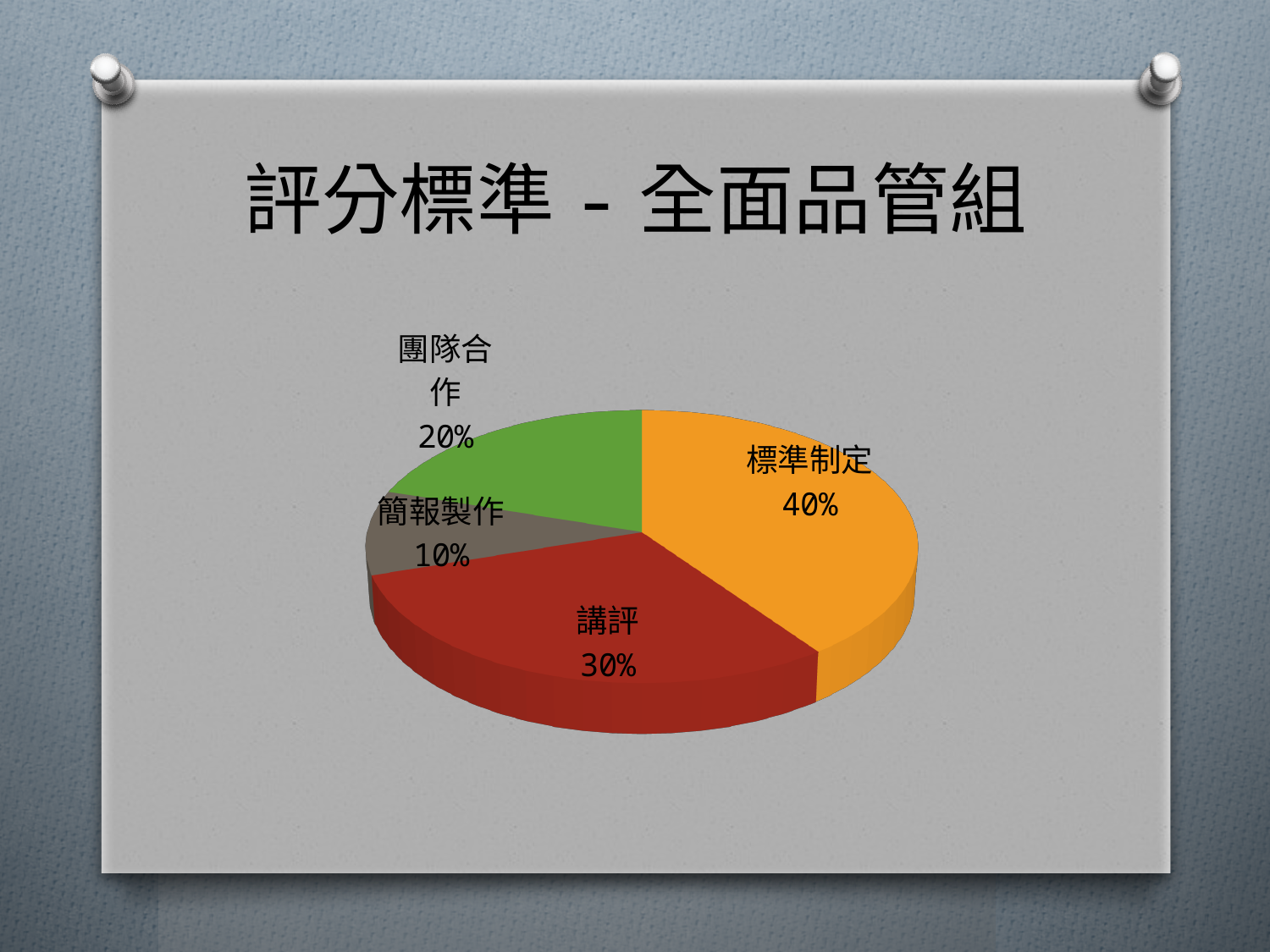
Which is larger, the share of 講評 or the share of 團隊合作? 講評 What share of the pie does 簡報製作 have? 10% What share of the pie does 團隊合作 have? 20% What share of the pie does 標準制定 have? 40% What is the difference between the shares of 團隊合作 and 簡報製作? 10% How many categories are shown in the pie chart? 4 What is the difference between the shares of 標準制定 and 講評? 10% Which category has the largest slice of the pie? 標準制定 What is the title of the slide containing the chart? 評分標準 - 全面品管組 What kind of chart is shown on the slide? Pie chart Which category has the smallest slice of the pie? 簡報製作 What share of the pie does 講評 have? 30%